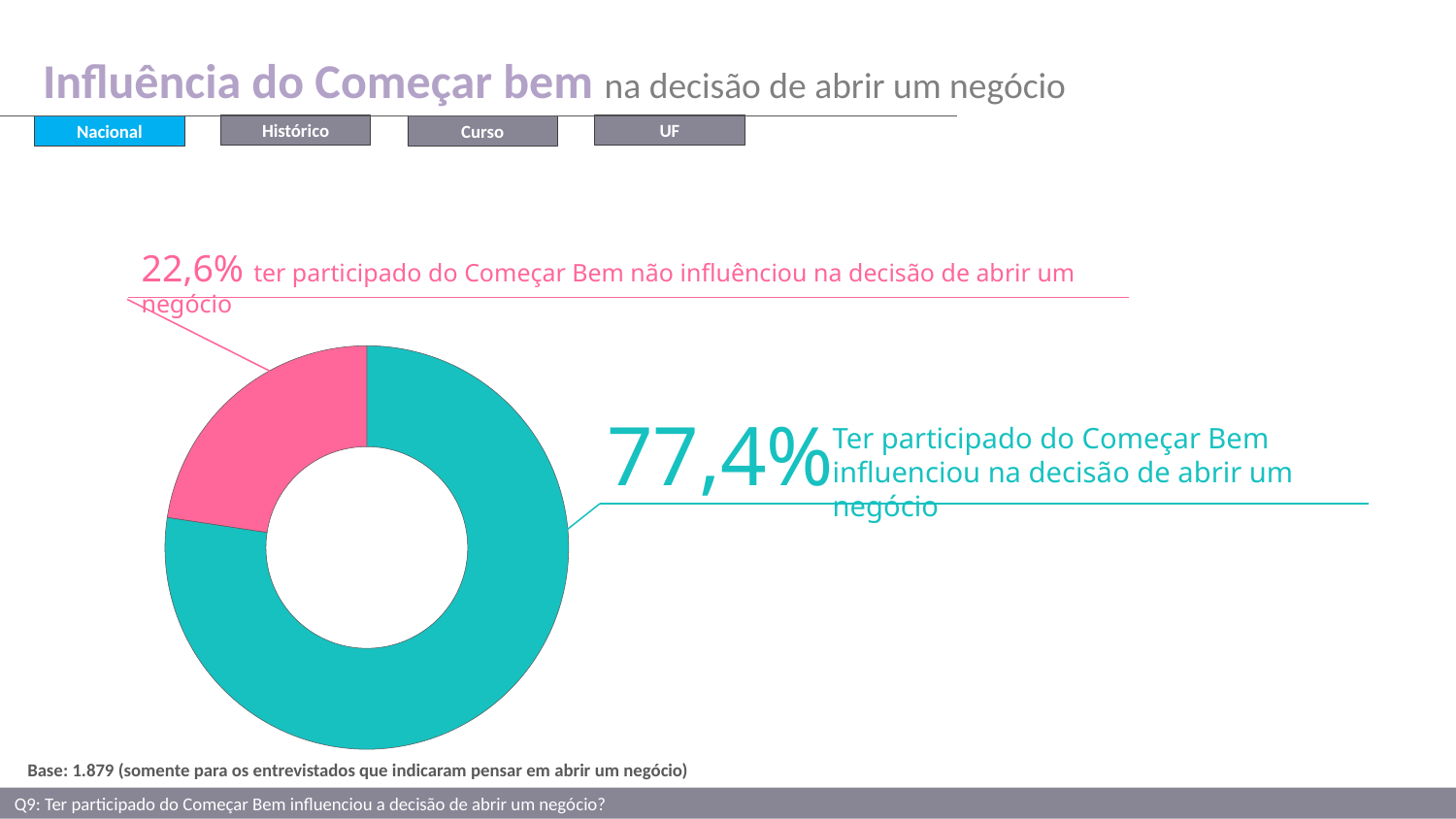
What share of respondents said that having participated in Começar Bem influenced their decision to open a business? 77,4% What kind of chart is shown on the slide? Donut (pie) chart What is the difference in percentage points between the 'influenciou' slice and the 'não influênciou' slice? 54,8 percentage points What colour is the slice representing 22,6%? Pink How many slices does the donut chart have? 2 What share of respondents said that having participated in Começar Bem did not influence their decision to open a business? 22,6% Which is larger: the share that said Começar Bem influenced their decision or the share that said it did not? The share that said it influenced (77,4%) What is the base (number of respondents) stated for the chart? 1.879 Do the two slices of the donut chart add up to 100%? Yes Which slice of the donut chart is the smallest? Ter participado do Começar Bem não influênciou na decisão de abrir um negócio (22,6%) What colour is the slice representing 77,4%? Teal (turquoise) Which slice of the donut chart is the largest? Ter participado do Começar Bem influenciou na decisão de abrir um negócio (77,4%)